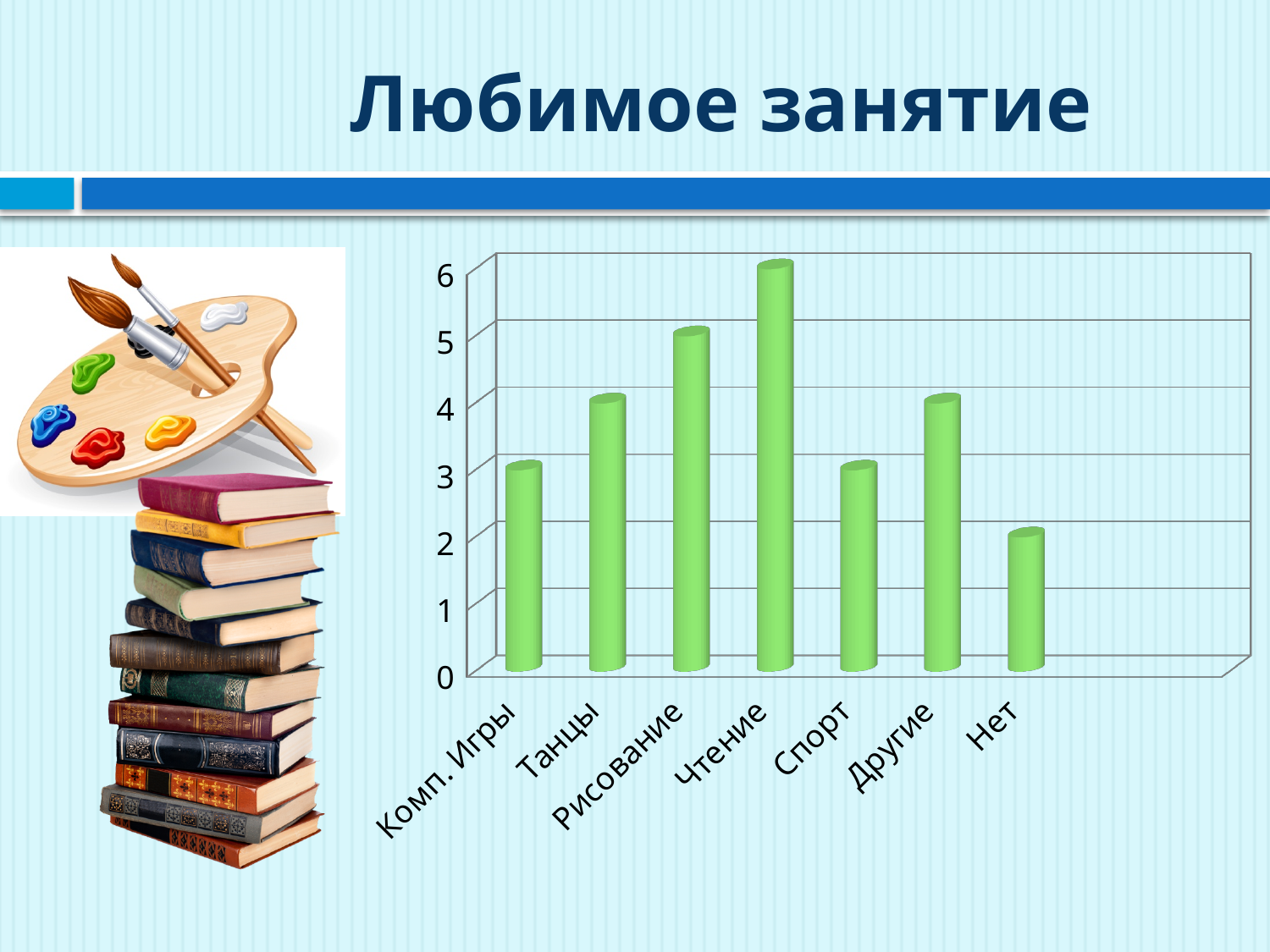
What is the title shown above the chart on the slide? Любимое занятие What kind of chart is shown on the slide? bar chart What is the value for Танцы? 4 What is the difference between the values for Чтение and Нет? 4 What is the value for Рисование? 5 Which category has the highest bar? Чтение What is the value for Чтение? 6 Which category has the lowest bar? Нет What is the value for Нет? 2 How many categories are shown on the x axis of the chart? 7 Which is larger, the value for Рисование or the value for Спорт? Рисование Is the value for Другие greater or less than 3? greater